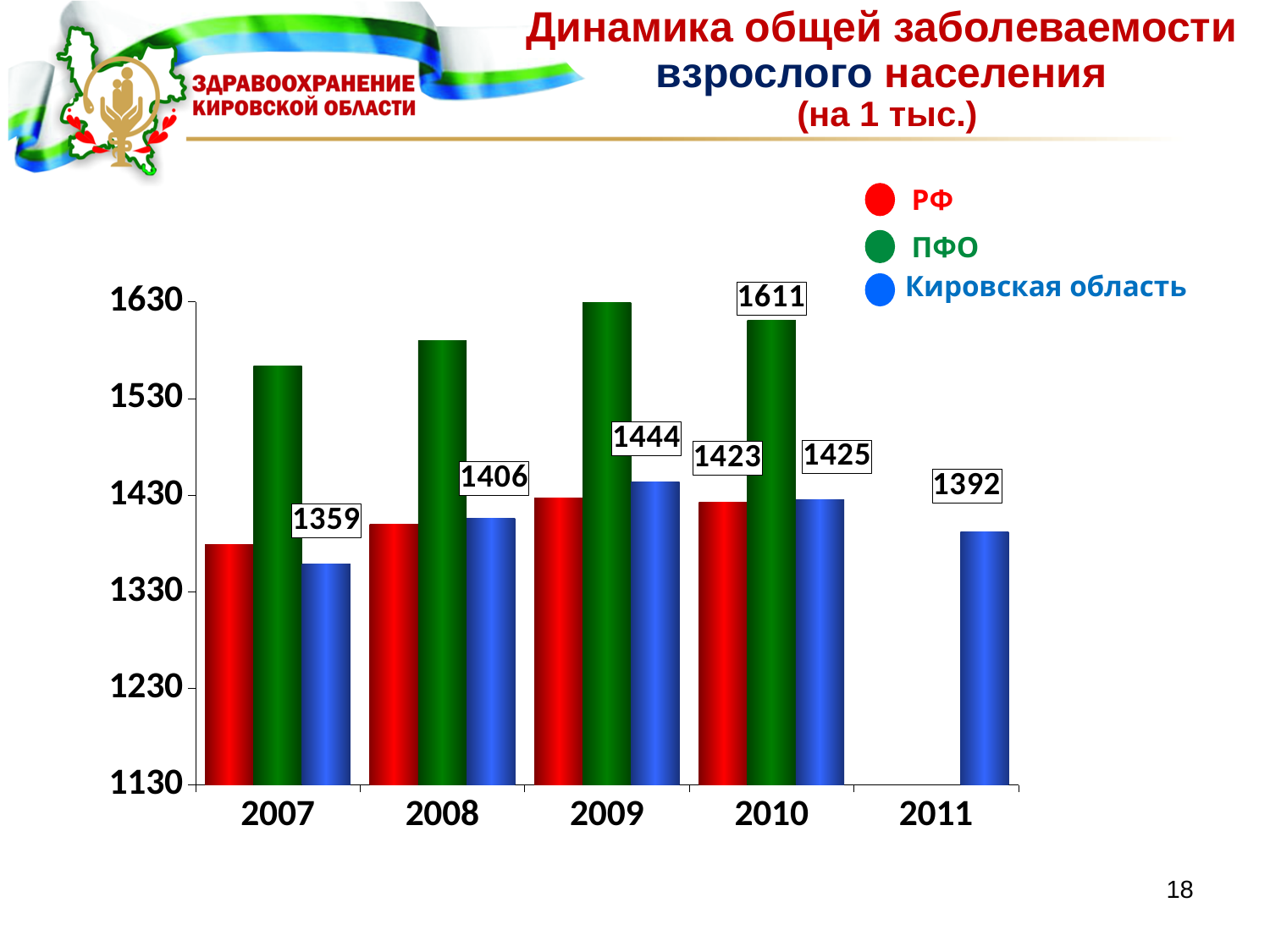
What is the difference between the ПФО and РФ values in 2010? 188 Is the value for РФ in 2007 greater or less than 1430? less In which year is the value for Кировская область lowest? 2007 In which year is the value for Кировская область highest? 2009 What type of chart is shown on the slide? bar chart Which series is shown in green in the legend? ПФО How many years are shown on the x axis? 5 What is the value for Кировская область in 2007? 1359 How many series does the legend list? 3 What is the value for РФ in 2010? 1423 What is the value for ПФО in 2010? 1611 What is the value for Кировская область in 2011? 1392